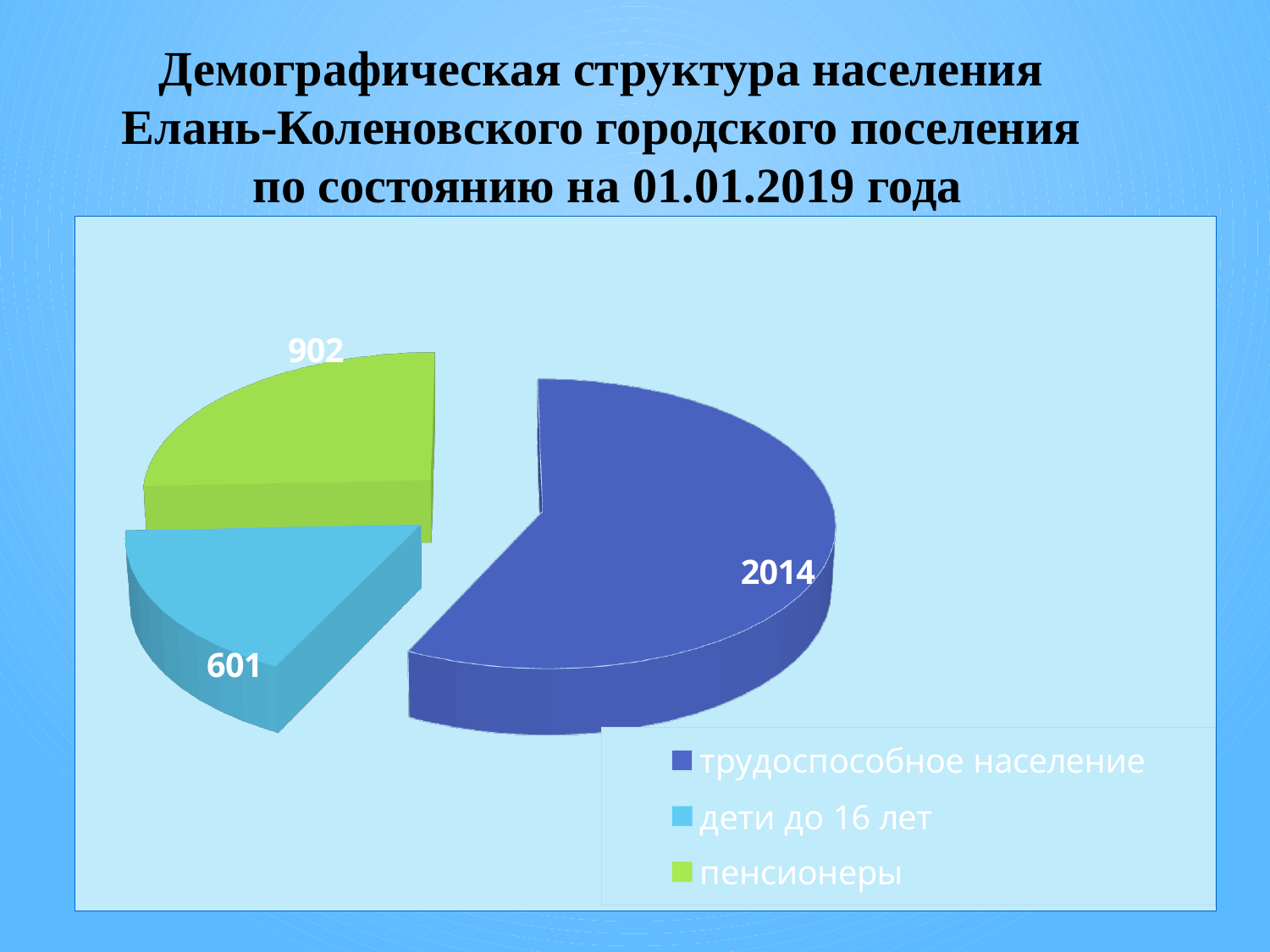
What kind of chart is shown on the slide? Pie chart Which category has the smallest slice of the pie? дети до 16 лет Which category has the largest slice of the pie? трудоспособное население What is the total of all three slices of the pie? 3517 What is the value for пенсионеры? 902 What is the difference between the values for трудоспособное население and пенсионеры? 1112 What is the value for трудоспособное население? 2014 What is the value for дети до 16 лет? 601 What colour is the slice for пенсионеры? Green Which is larger, the value for пенсионеры or the value for дети до 16 лет? пенсионеры How many categories does the pie chart have? 3 What is the difference between the values for пенсионеры and дети до 16 лет? 301